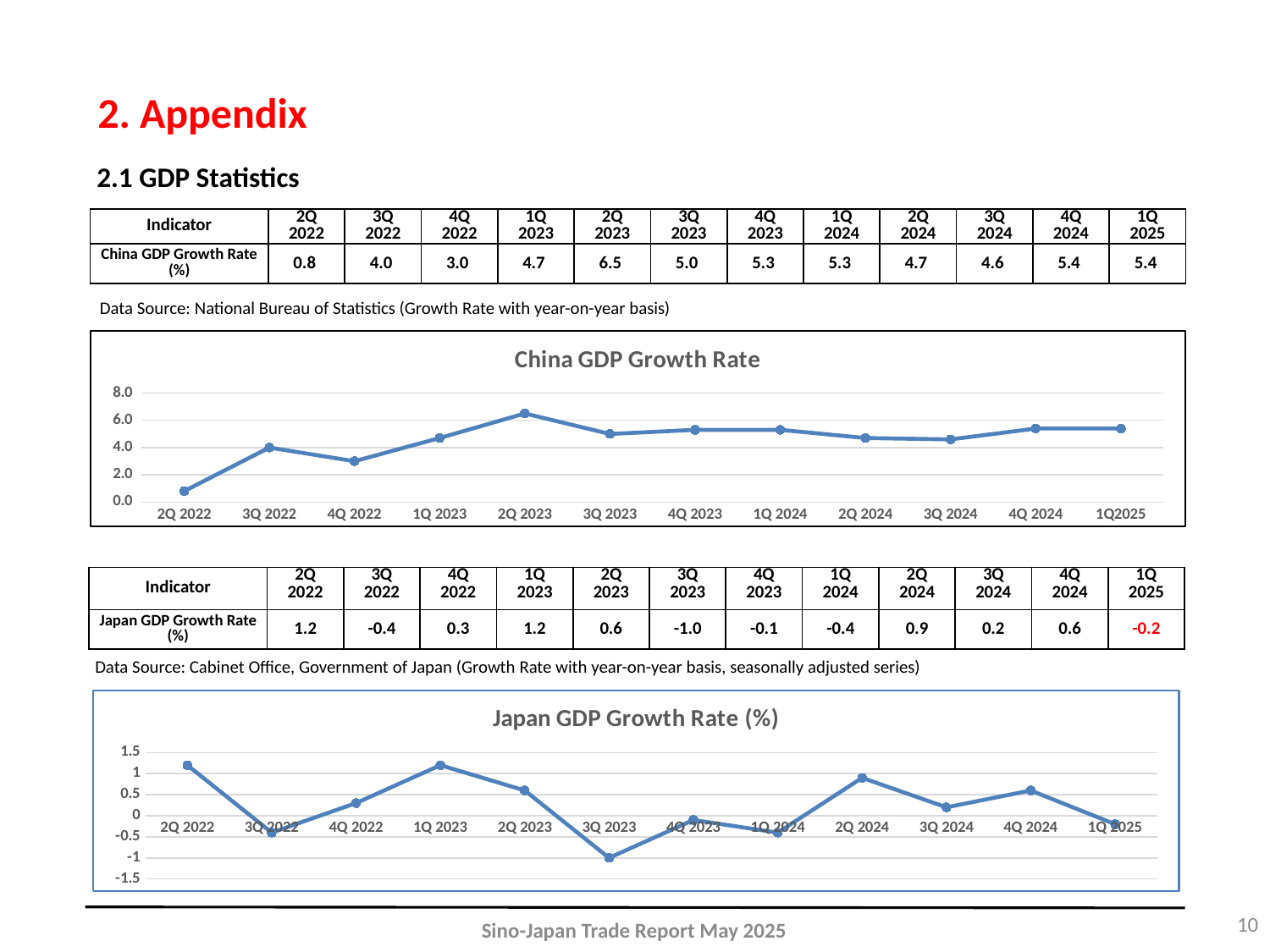
In the Japan GDP Growth Rate (%) chart, what is the value for 1Q 2025? -0.2 In the China GDP Growth Rate chart, is the value for 4Q 2022 greater or less than 4.0? less In the China GDP Growth Rate chart, which quarter has the highest value? 2Q 2023 In the Japan GDP Growth Rate (%) chart, which quarter has the lowest value? 3Q 2023 In the Japan GDP Growth Rate (%) chart, which is larger, the value for 2Q 2024 or the value for 3Q 2024? 2Q 2024 In the China GDP Growth Rate chart, which quarter has the lowest value? 2Q 2022 In the China GDP Growth Rate chart, what is the value for 2Q 2023? 6.5 In the China GDP Growth Rate chart, how many quarters are plotted? 12 In the Japan GDP Growth Rate (%) chart, do the values rise or fall from 2Q 2024 to 3Q 2024? fall In the Japan GDP Growth Rate (%) chart, what is the difference between the values for 1Q 2023 and 3Q 2023? 2.2 What type of chart is the China GDP Growth Rate chart? Line chart In the China GDP Growth Rate chart, what is the difference between the values for 2Q 2023 and 2Q 2022? 5.7